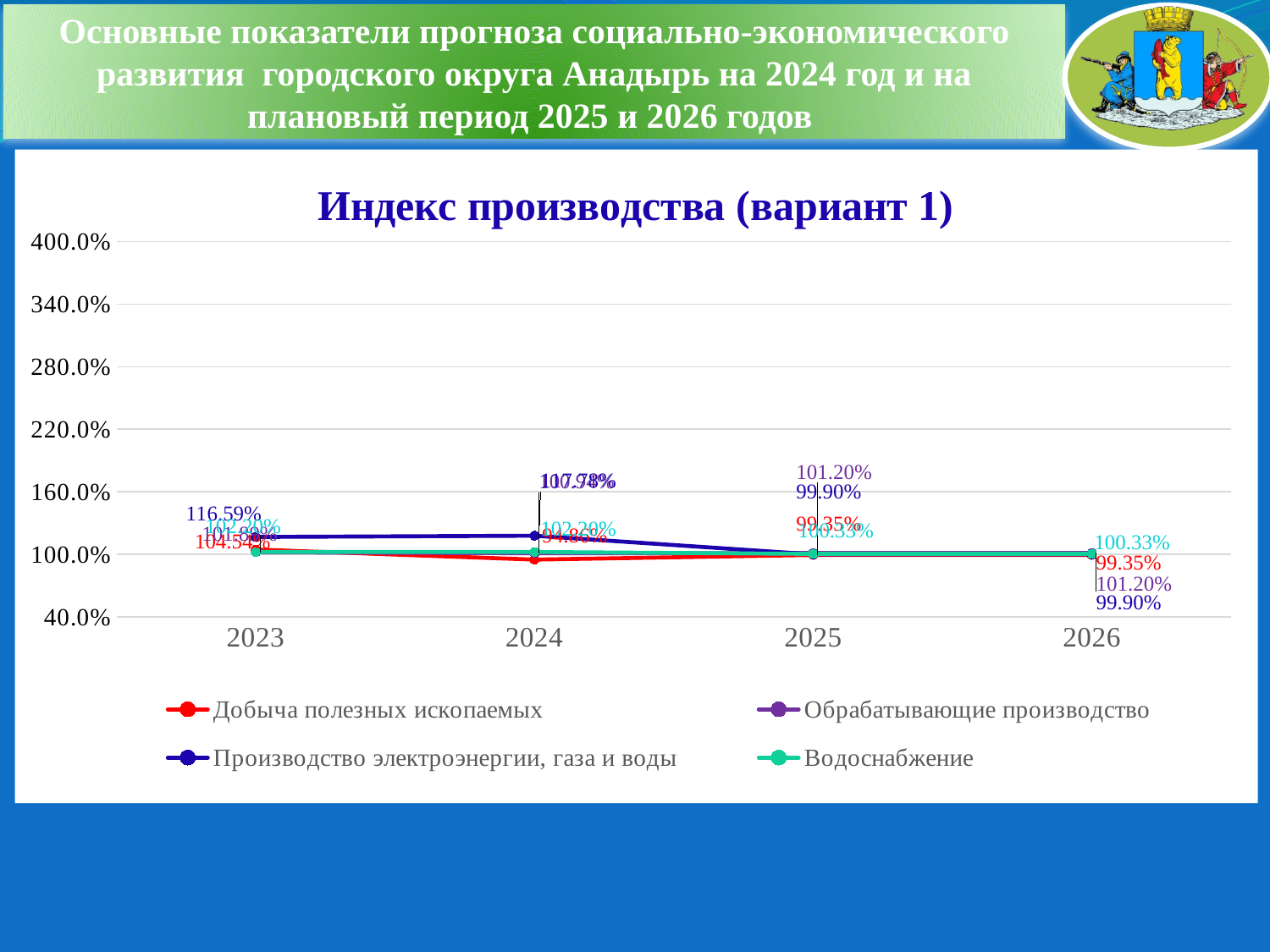
What is the title of the chart? Индекс производства (вариант 1) What is the value for Обрабатывающие производство in 2026? 101.20% How many years are shown on the x axis? 4 What kind of chart is shown on the slide? line chart What is the value for Производство электроэнергии, газа и воды in 2023? 116.59% Which series has the highest value in 2023? Производство электроэнергии, газа и воды Does the value for Добыча полезных ископаемых rise or fall from 2023 to 2024? fall How many series does the legend list? 4 What is the value for Добыча полезных ископаемых in 2026? 99.35% What is the value for Водоснабжение in 2026? 100.33% What is the value for Добыча полезных ископаемых in 2024? 94.86% In 2026, which is larger: Обрабатывающие производство or Добыча полезных ископаемых? Обрабатывающие производство